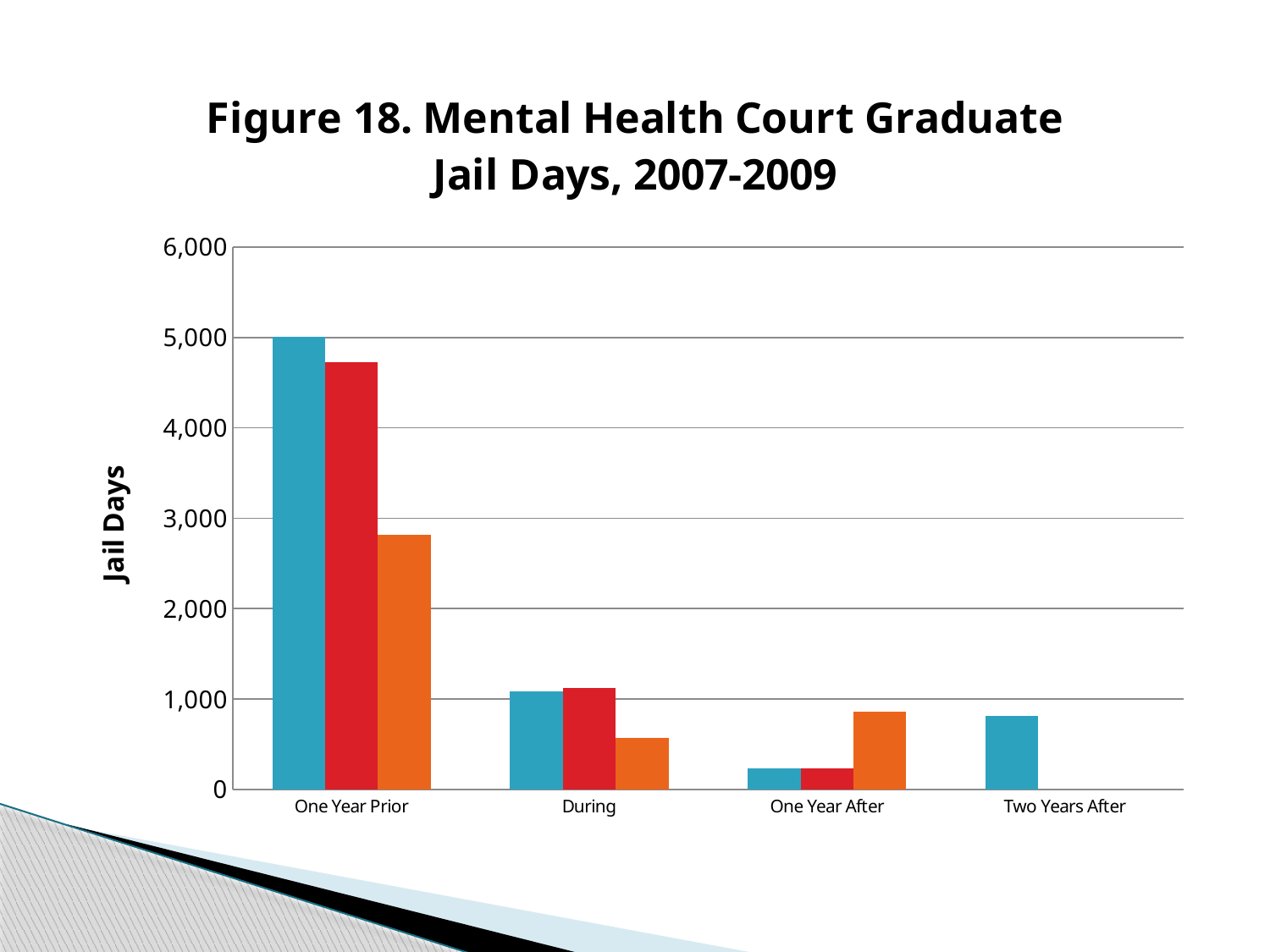
Is the value of the orange bar for During greater or less than 1,000? less Do the blue bars rise or fall from One Year Prior to One Year After? fall Which category has the highest blue bar? One Year Prior How many categories are shown on the x axis? 4 Is the value of the blue bar for One Year Prior greater or less than 4,000? greater Which category has the lowest blue bar? One Year After For One Year Prior, which is larger: the blue bar or the orange bar? the blue bar For One Year After, which is larger: the orange bar or the blue bar? the orange bar What kind of chart is shown on the slide? bar chart What is the label on the y axis? Jail Days Is the value of the orange bar for One Year Prior greater or less than 3,000? less